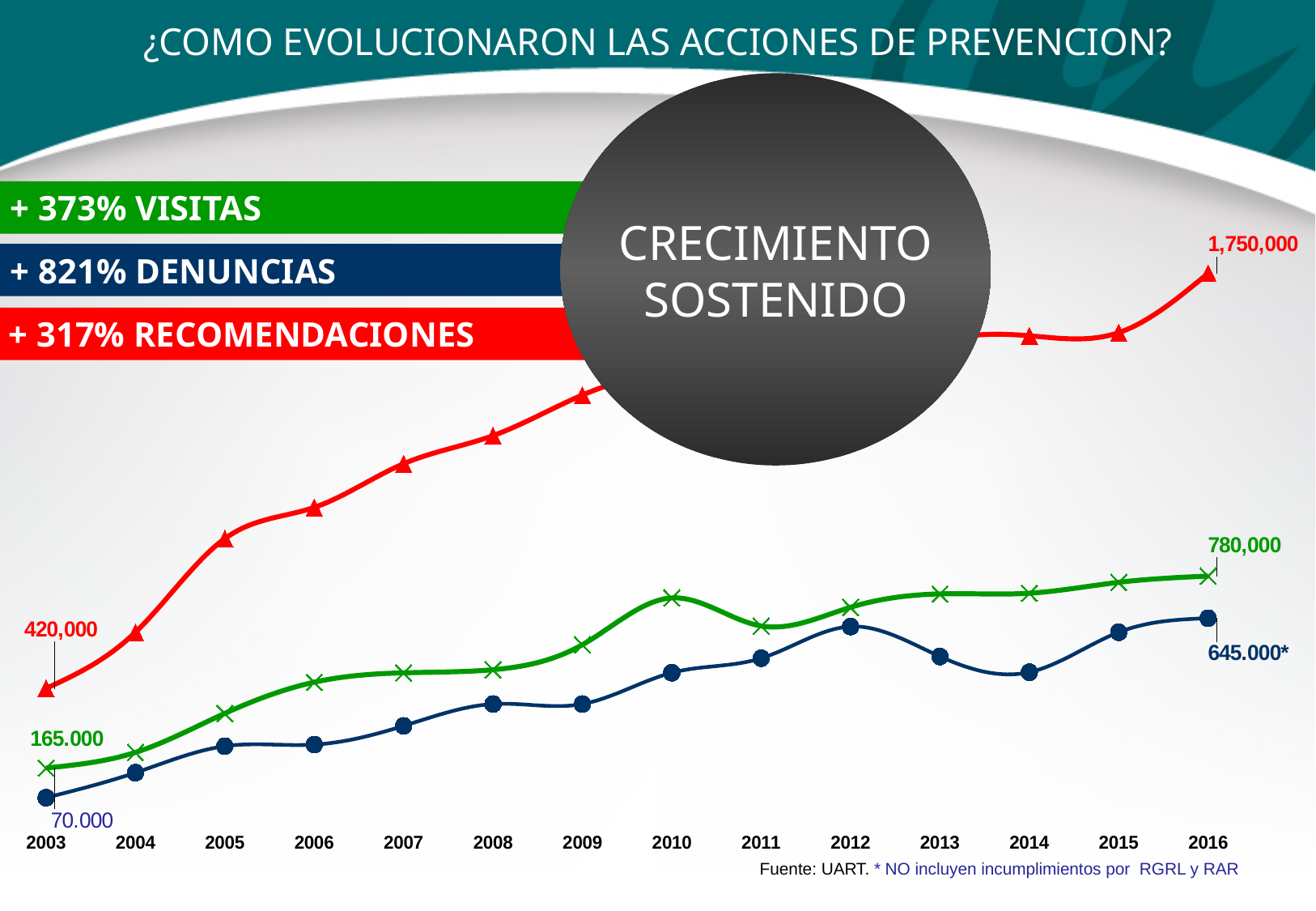
What is the value of the green VISITAS line in 2003? 165.000 What kind of chart is shown on the slide? line chart Which series has the highest value in 2016? RECOMENDACIONES Does the red RECOMENDACIONES line rise or fall from 2003 to 2016? rise Which series has the lowest value in 2003? DENUNCIAS What is the value of the blue DENUNCIAS line in 2003? 70.000 What is the value of the red RECOMENDACIONES line in 2016? 1,750,000 What is the value of the red RECOMENDACIONES line in 2003? 420,000 How many years are shown on the x axis of the chart? 14 By how much did the red RECOMENDACIONES line increase from 2003 to 2016? 1,330,000 What is the value of the blue DENUNCIAS line in 2016? 645.000* What is the value of the green VISITAS line in 2016? 780,000